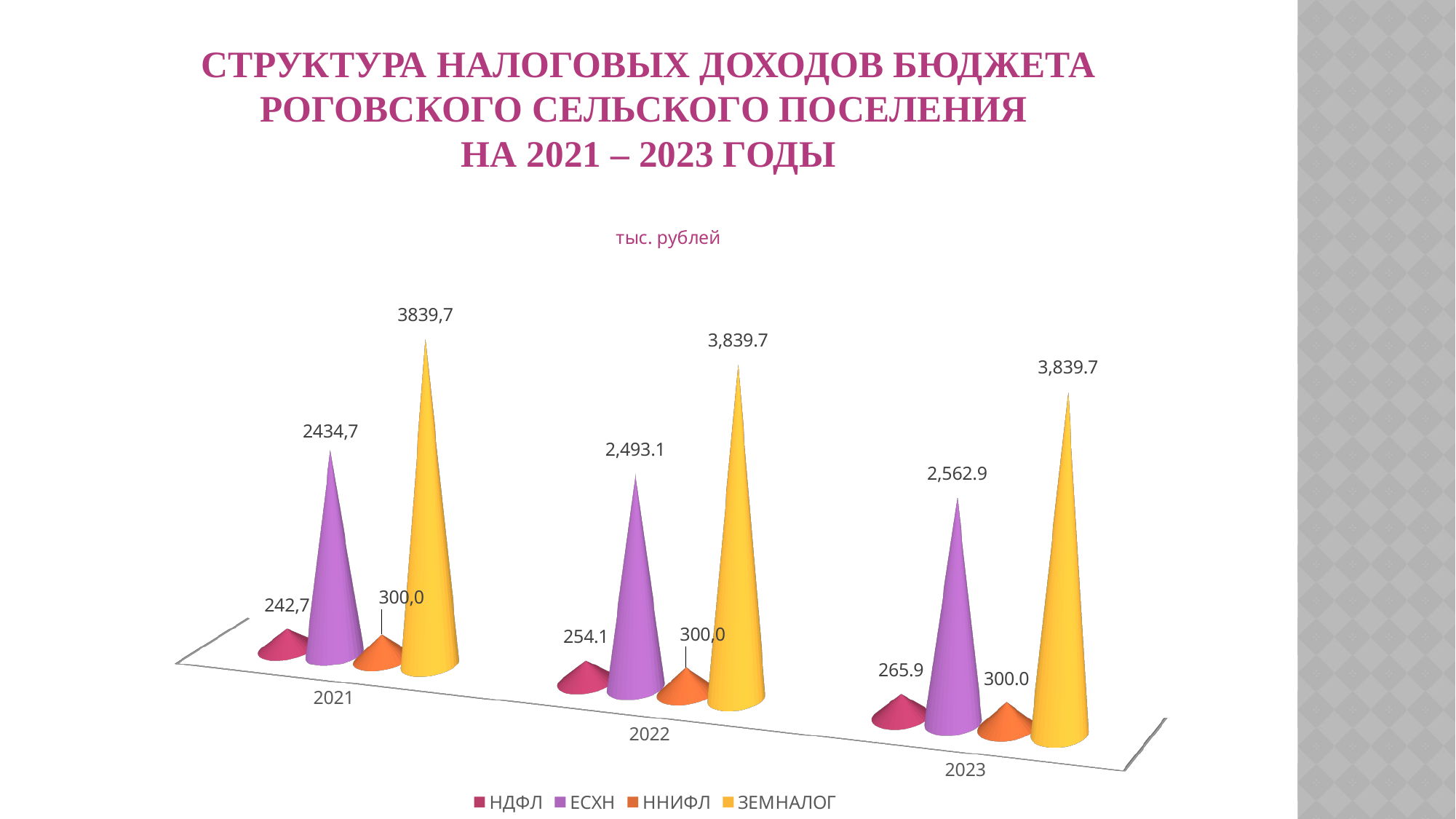
How many series does the legend list? 4 Which series has the highest value in 2022? ЗЕМНАЛОГ Which series has the lowest value in 2021? НДФЛ What is the value for ННИФЛ in 2023? 300.0 What is the difference between ЗЕМНАЛОГ and ЕСХН in 2021? 1405,0 What kind of chart is shown on the slide? bar chart What is the value for ЕСХН in 2022? 2,493.1 What is the value for ЗЕМНАЛОГ in 2021? 3839,7 What is the value for НДФЛ in 2023? 265.9 How many years (categories) are shown on the x axis? 3 Do the values for НДФЛ rise or fall from 2021 to 2023? rise Which is larger in 2023: ЕСХН or ННИФЛ? ЕСХН